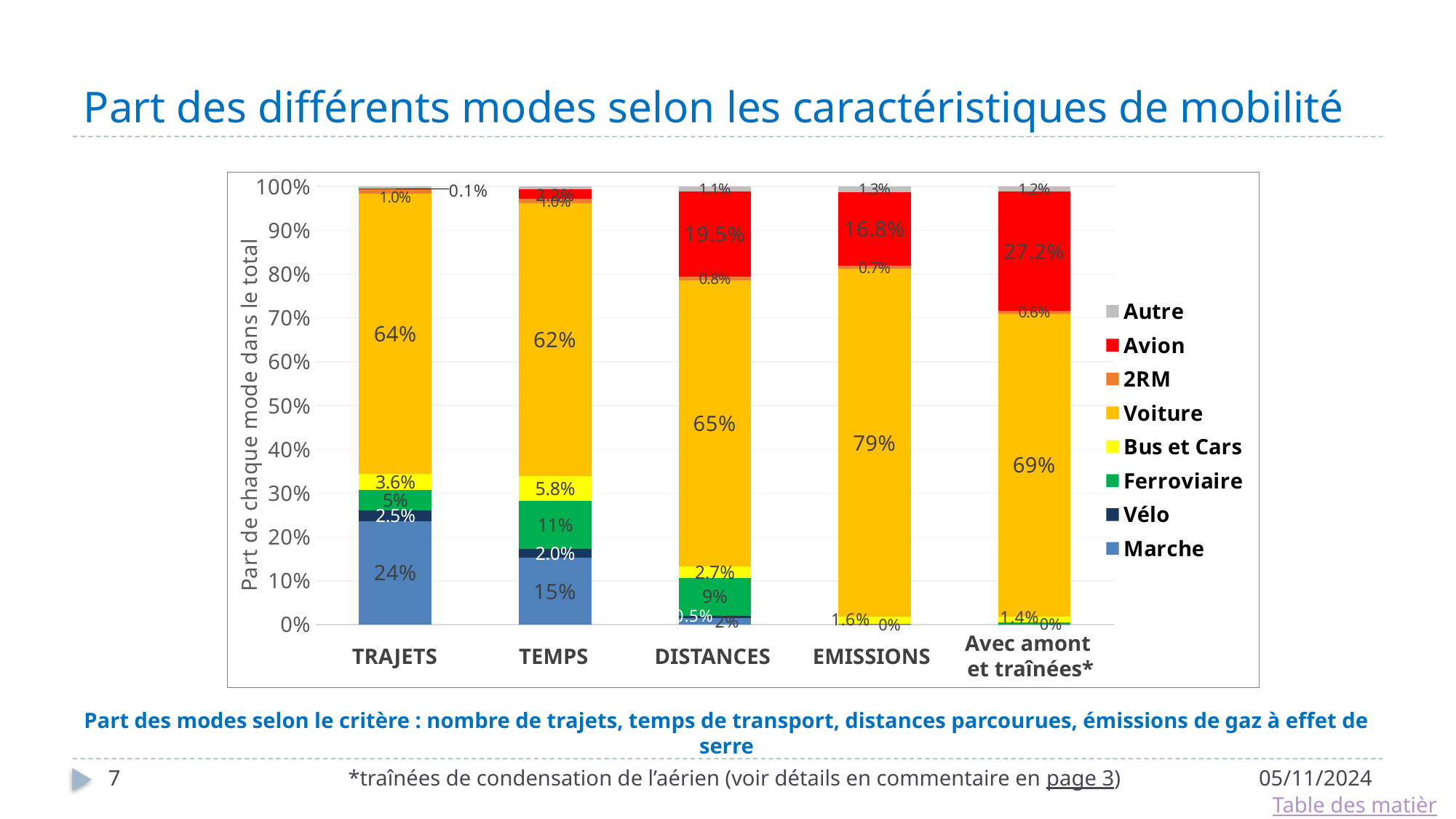
In which category is the Avion share the highest? Avec amont et traînées* What is the Voiture share for EMISSIONS? 79% What is the difference between the Voiture share for TRAJETS and for TEMPS? 2 percentage points What kind of chart is shown on the slide? Stacked bar chart How many categories are shown on the x axis? 5 What is the Avion share for DISTANCES? 19.5% What is the Marche share for TRAJETS? 24% What is the Ferroviaire share for TEMPS? 11% What is the Avion share for the 'Avec amont et traînées*' category? 27.2% Which category has the larger Marche share, TRAJETS or TEMPS? TRAJETS In which category is the Voiture share the lowest? TEMPS How many series does the legend list? 8